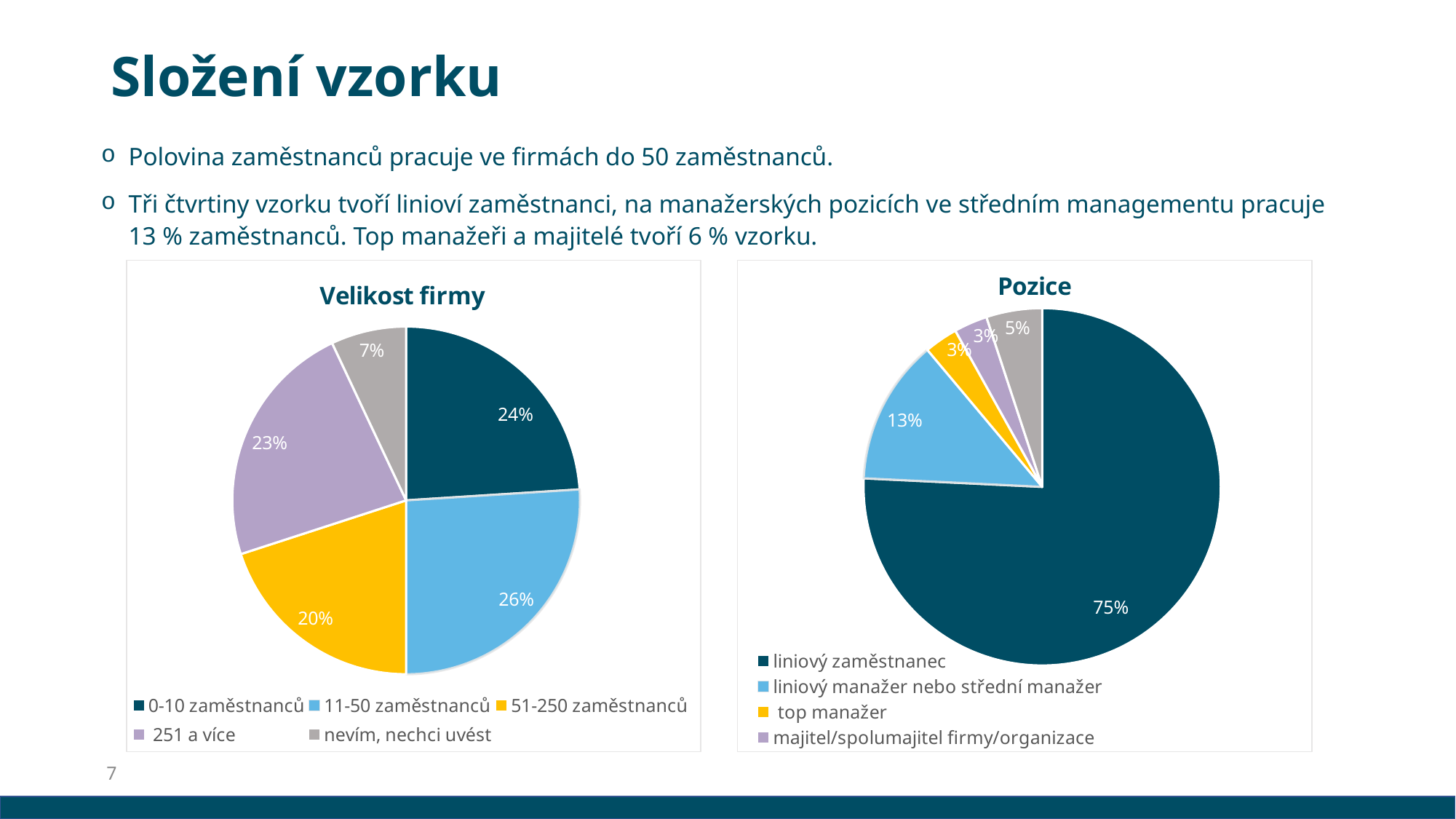
In the 'Pozice' chart, which category has the largest share? liniový zaměstnanec In the 'Velikost firmy' chart, what is the value for '251 a více'? 23% In the 'Pozice' chart, what is the value for 'liniový manažer nebo střední manažer'? 13% In the 'Pozice' chart, which is larger: 'liniový zaměstnanec' or 'liniový manažer nebo střední manažer'? liniový zaměstnanec In the 'Velikost firmy' chart, how many categories does the legend list? 5 In the 'Velikost firmy' chart, which category has the largest share? 11-50 zaměstnanců In the 'Velikost firmy' chart, what is the difference between the shares for '0-10 zaměstnanců' and '51-250 zaměstnanců'? 4 percentage points In the 'Velikost firmy' chart, what share of the sample works in companies with 11-50 zaměstnanců? 26% In the 'Velikost firmy' chart, which category has the smallest share? nevím, nechci uvést What type of chart is the 'Pozice' chart? Pie chart In the 'Pozice' chart, what share of the sample is 'liniový zaměstnanec'? 75% In the 'Velikost firmy' chart, what colour is the slice for '51-250 zaměstnanců'? Yellow